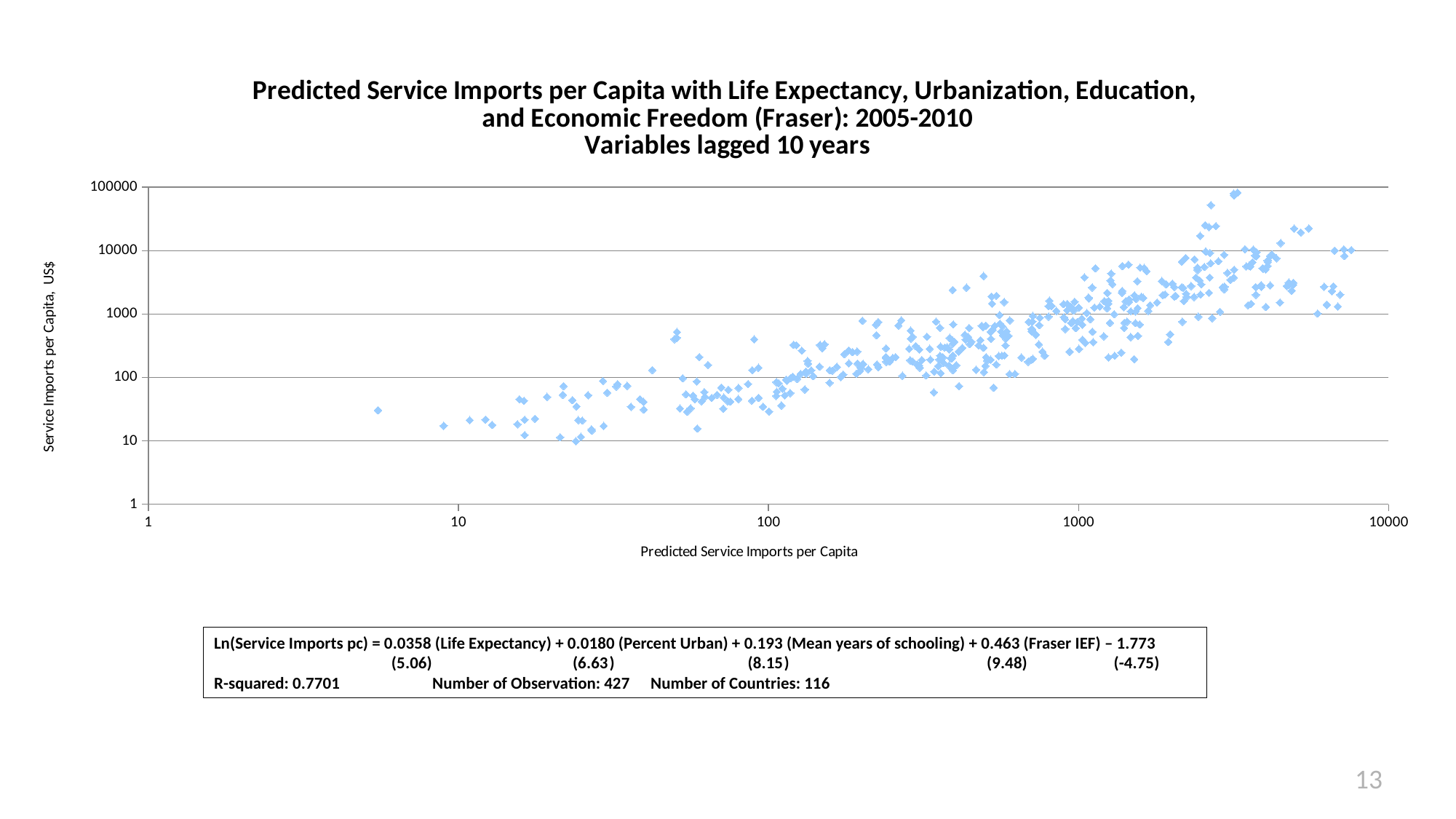
What kind of chart is shown on the slide? scatter plot Is the x value of the rightmost plotted point greater or less than 1000? greater Is the y value of the highest plotted point greater or less than 10000? greater As Predicted Service Imports per Capita increases along the x axis, do the plotted Service Imports per Capita values generally rise or fall? rise Is the y value of the leftmost plotted point greater or less than 100? less What is the maximum tick value shown on the x axis? 10000 What is the maximum tick value shown on the y axis? 100000 What is the label of the y axis? Service Imports per Capita, US$ What is the label of the x axis? Predicted Service Imports per Capita